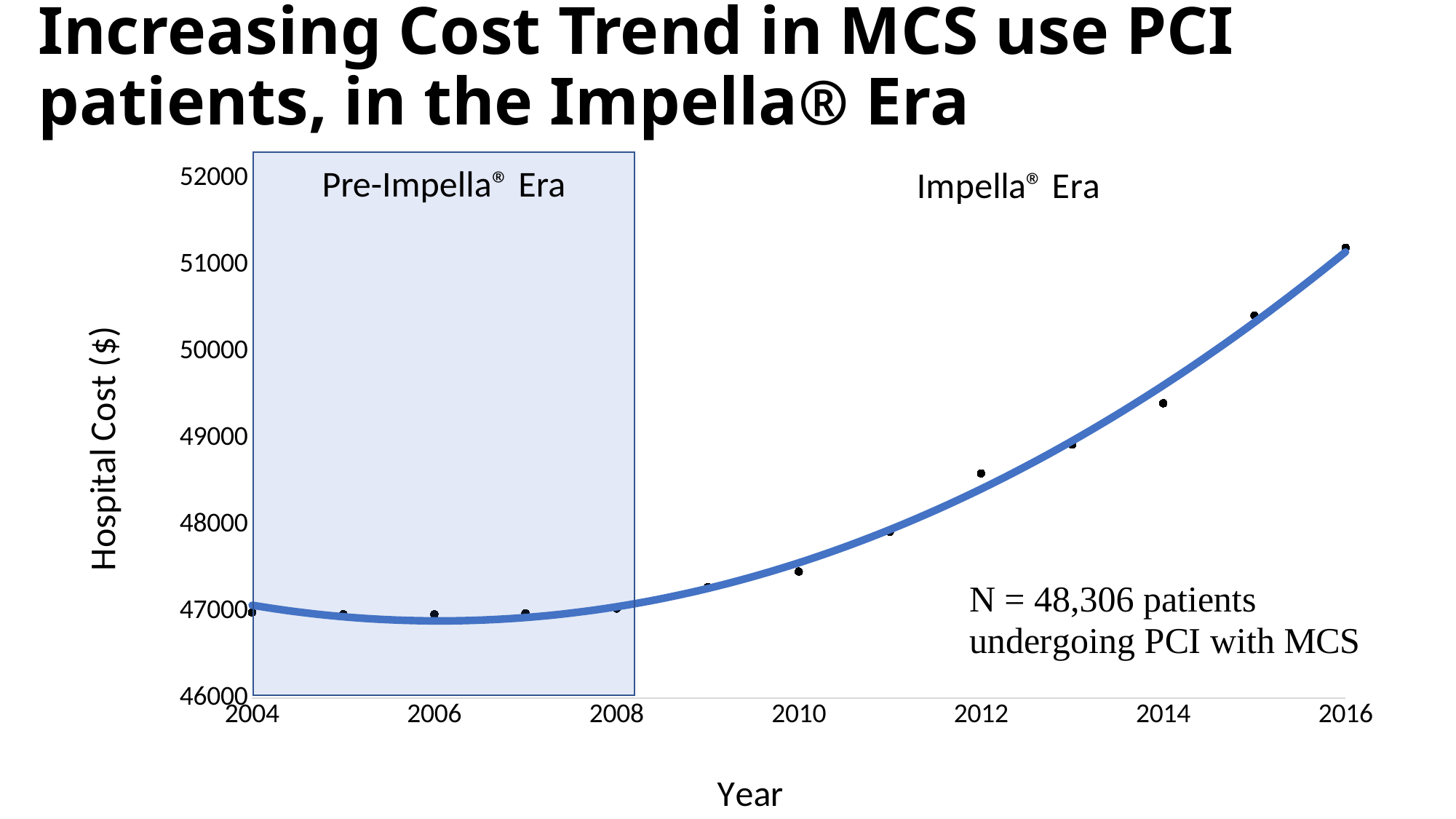
What kind of chart is shown on the slide? Scatter chart with a fitted trend line Which year has the highest hospital cost? 2016 Is the hospital cost for 2016 greater or less than 51000? greater Is the hospital cost for 2012 greater or less than 48000? greater How many data points are plotted on the chart? 13 Is the hospital cost for 2014 greater or less than 49000? greater What is the label of the vertical axis? Hospital Cost ($) Does hospital cost rise or fall from 2008 to 2016? Rise Which year has the larger hospital cost, 2012 or 2014? 2014 Which year has the larger hospital cost, 2004 or 2016? 2016